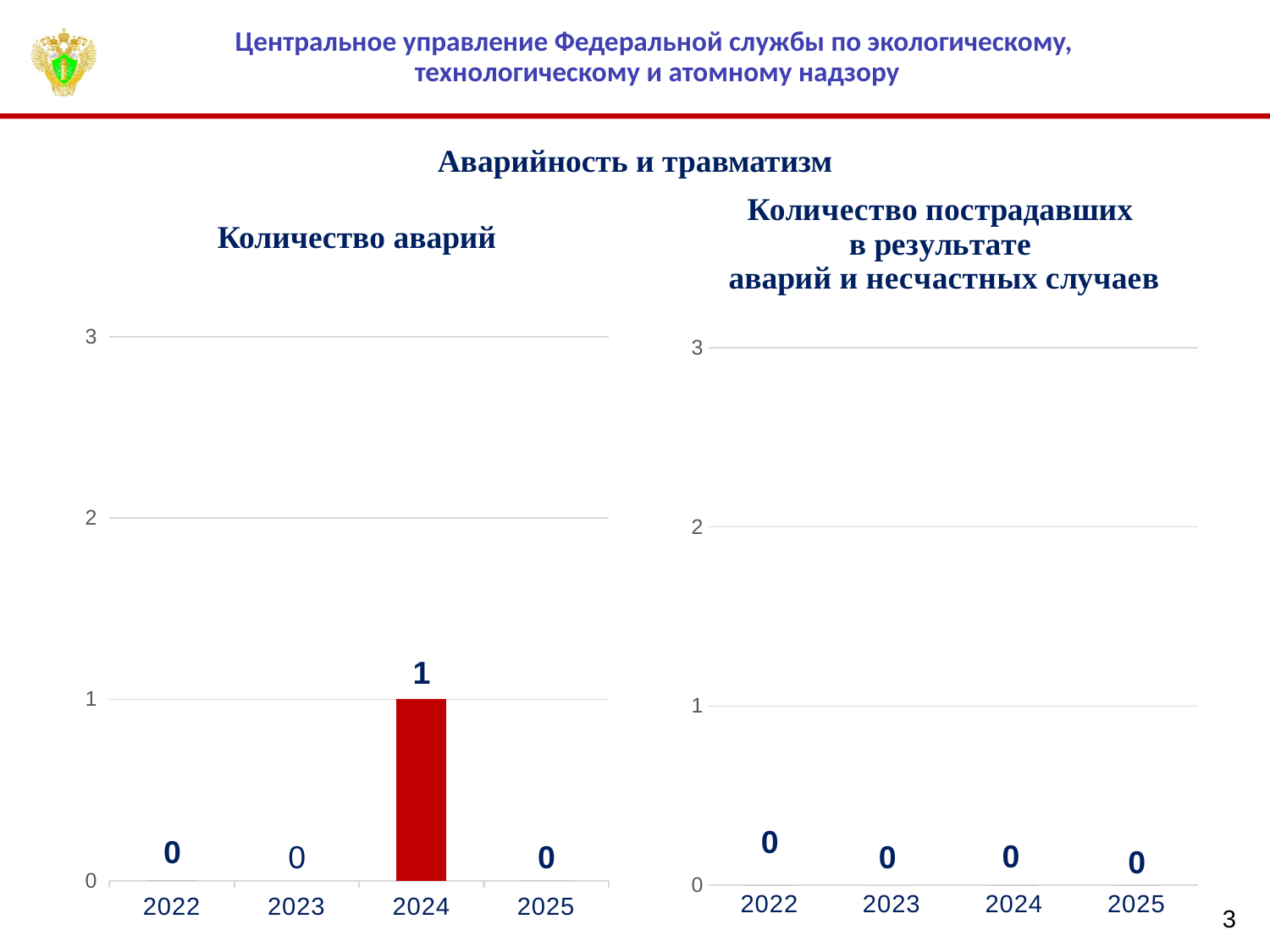
In the 'Количество аварий' chart, which is larger, the value for 2024 or the value for 2025? 2024 In the 'Количество аварий' chart, what is the difference between the values for 2024 and 2023? 1 In the 'Количество аварий' chart, what is the value for 2022? 0 What kind of chart is the 'Количество аварий' chart? bar chart In the 'Количество пострадавших в результате аварий и несчастных случаев' chart, how many years are shown on the x axis? 4 In the 'Количество аварий' chart, which year has the highest value? 2024 In the 'Количество пострадавших в результате аварий и несчастных случаев' chart, what is the value for 2023? 0 In the 'Количество аварий' chart, what is the value for 2024? 1 In the 'Количество аварий' chart, how many years are shown on the x axis? 4 In the 'Количество пострадавших в результате аварий и несчастных случаев' chart, what is the value for 2025? 0 In the 'Количество аварий' chart, is the value for 2024 greater or less than 2? less What colour is the bar for 2024 in the 'Количество аварий' chart? red